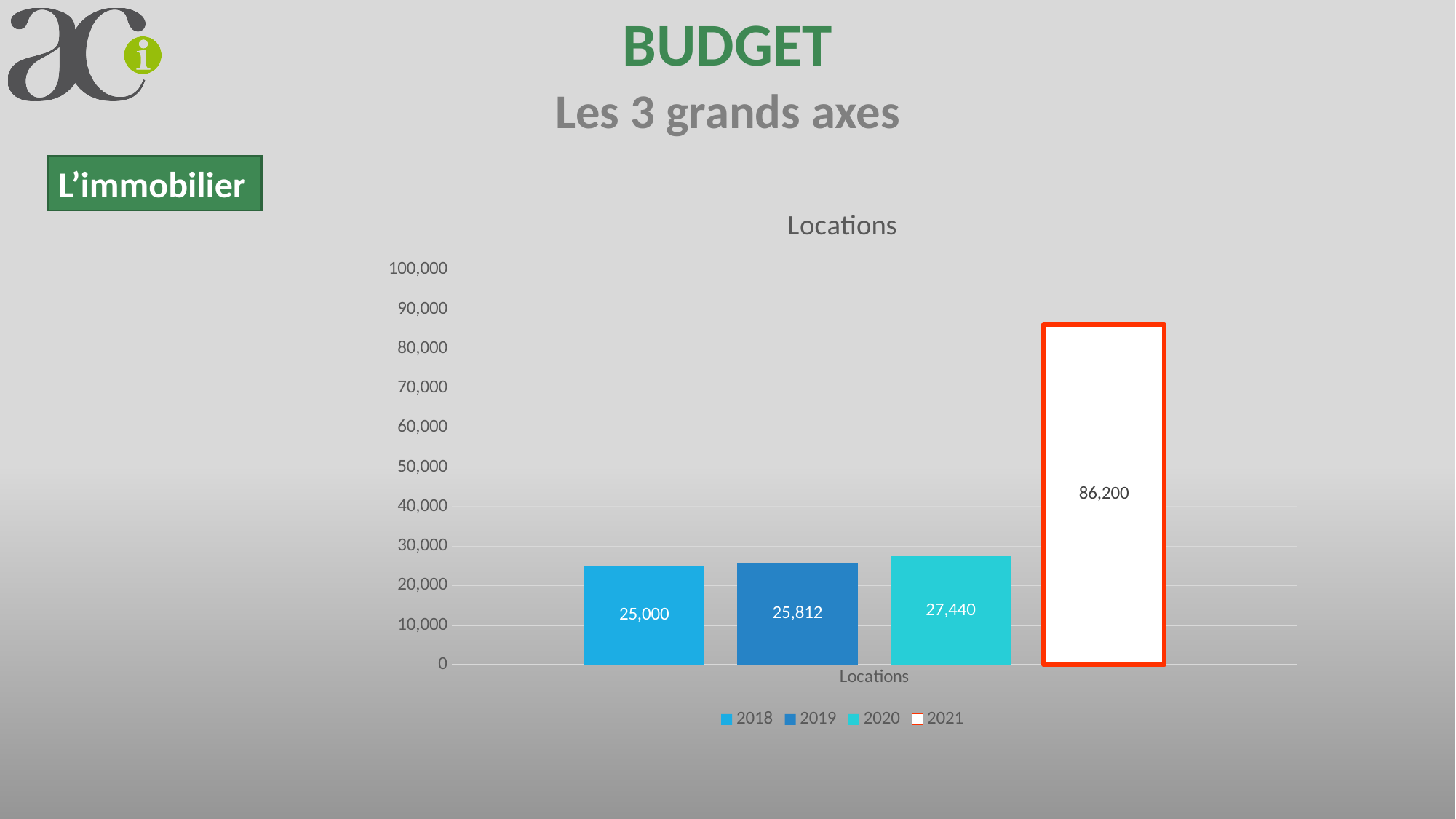
Which is larger in the Locations chart, the value for 2020 or the value for 2019? 2020 Do the values in the Locations chart rise or fall from 2018 to 2021? Rise What is the value for 2019 in the Locations chart? 25,812 What is the difference between the 2019 and 2018 values in the Locations chart? 812 Which year has the lowest value in the Locations chart? 2018 What is the value for 2021 in the Locations chart? 86,200 What is the value for 2018 in the Locations chart? 25,000 How many series does the legend of the Locations chart list? 4 Which year has the highest value in the Locations chart? 2021 What is the difference between the 2021 and 2020 values in the Locations chart? 58,760 What kind of chart is the Locations chart? Bar chart What is the value for 2020 in the Locations chart? 27,440